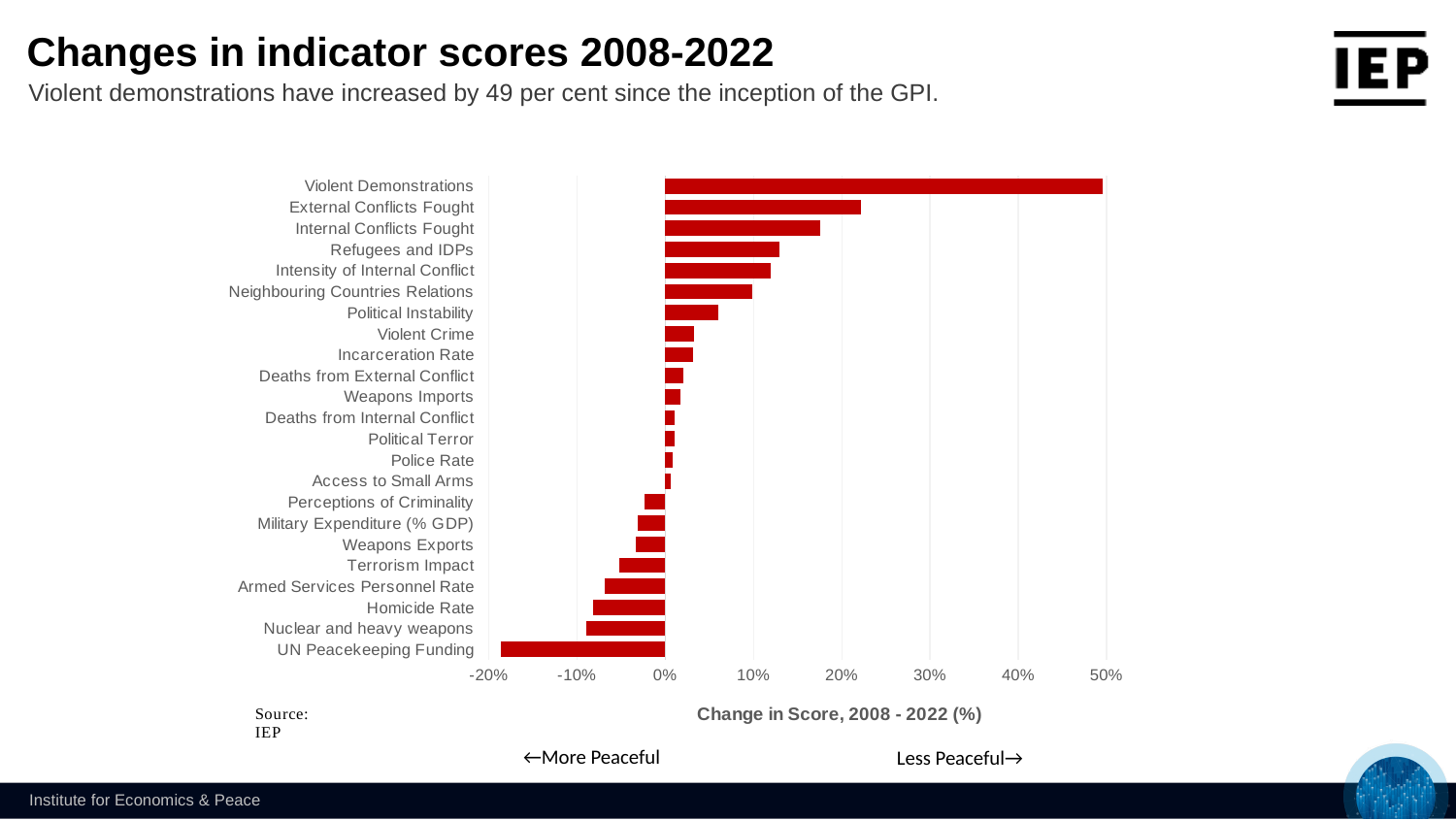
What is the title of the horizontal axis? Change in Score, 2008 - 2022 (%) Which indicator has the highest change in score? Violent Demonstrations Is the value for Political Instability greater or less than 10%? less Is the value for Violent Demonstrations greater or less than 40%? greater Is the value for Internal Conflicts Fought greater or less than 20%? less What kind of chart is shown on the slide? bar chart How many indicators are plotted in the chart? 23 Which indicator has the lowest (most negative) change in score? UN Peacekeeping Funding Which indicator shows the larger decrease, Homicide Rate or Terrorism Impact? Homicide Rate Which has the larger change in score, External Conflicts Fought or Internal Conflicts Fought? External Conflicts Fought